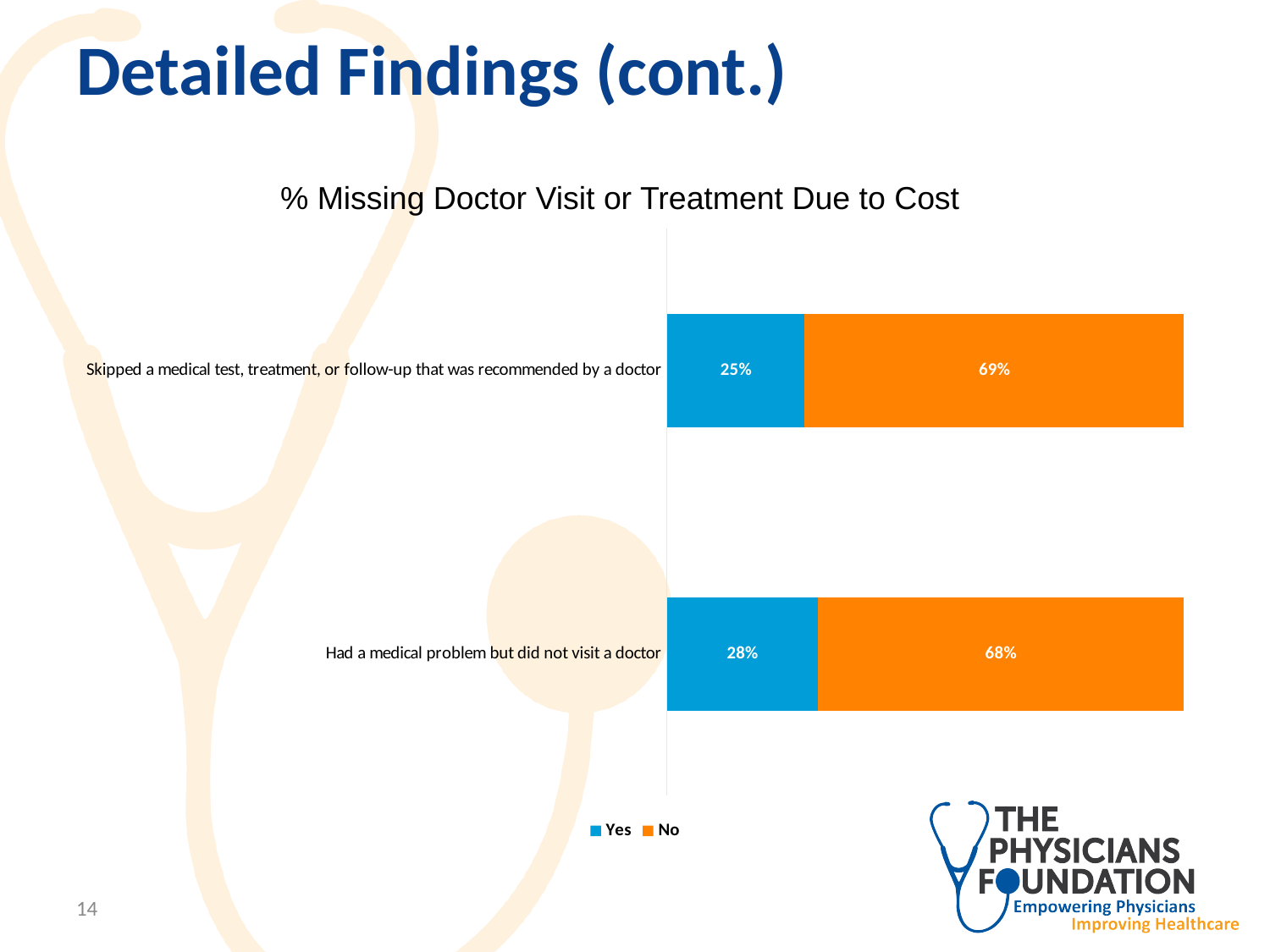
What is the difference between the Yes percentages for the two categories? 3% What percentage answered Yes to 'Had a medical problem but did not visit a doctor'? 28% What percentage answered Yes to 'Skipped a medical test, treatment, or follow-up that was recommended by a doctor'? 25% What type of chart is shown on the slide? Stacked bar chart What is the combined Yes and No total for 'Had a medical problem but did not visit a doctor'? 96% Is the No value larger for 'Skipped a medical test, treatment, or follow-up that was recommended by a doctor' or for 'Had a medical problem but did not visit a doctor'? Skipped a medical test, treatment, or follow-up that was recommended by a doctor What is the combined Yes and No total for 'Skipped a medical test, treatment, or follow-up that was recommended by a doctor'? 94% How many series does the legend list? 2 What percentage answered No to 'Skipped a medical test, treatment, or follow-up that was recommended by a doctor'? 69% How many categories are shown in the chart? 2 Which category has the higher Yes percentage? Had a medical problem but did not visit a doctor What percentage answered No to 'Had a medical problem but did not visit a doctor'? 68%